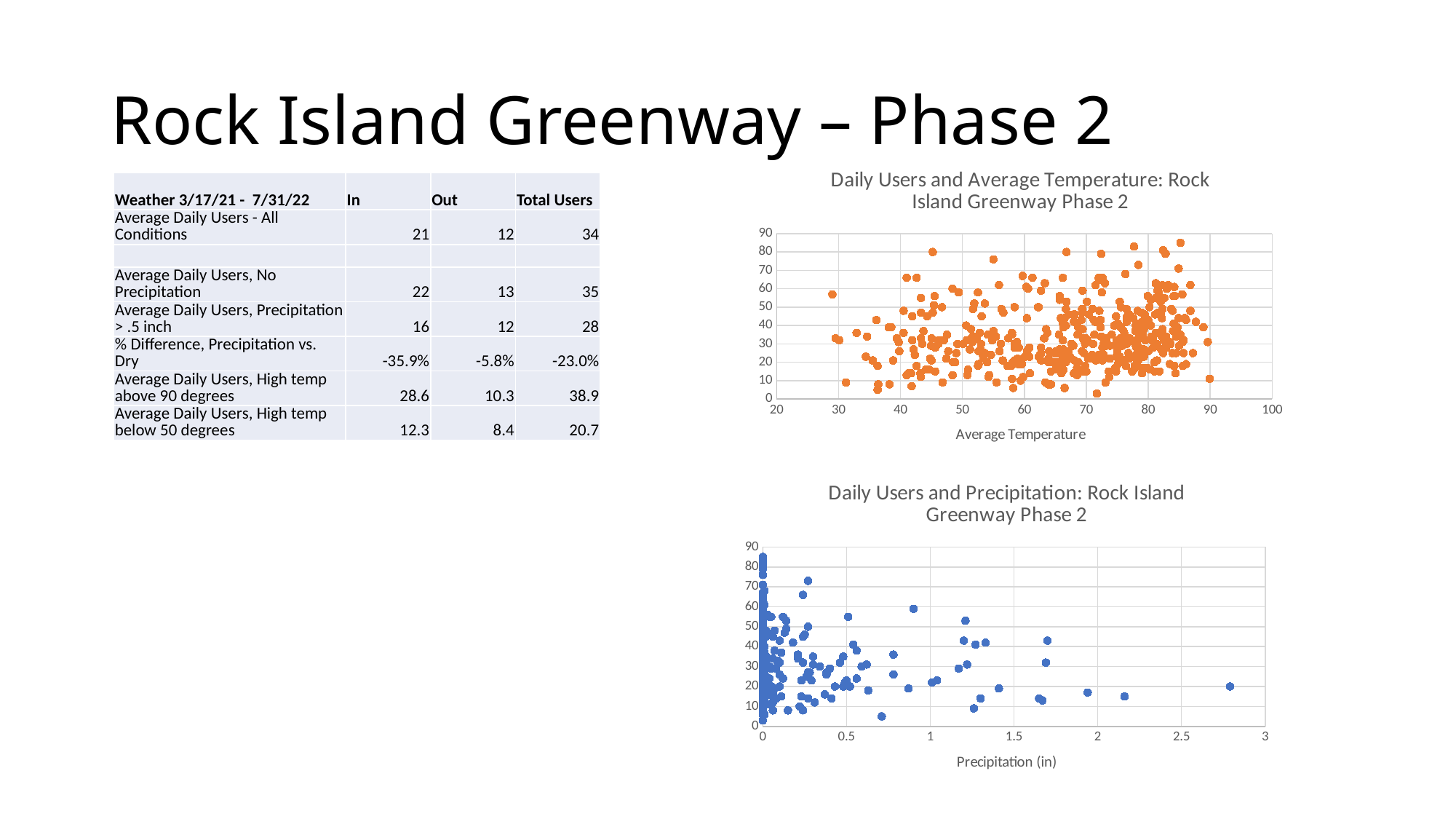
In the "Daily Users and Precipitation" chart, what is the label on the x axis? Precipitation (in) In the "Daily Users and Precipitation" chart, is the largest precipitation value plotted greater or less than 2.5? greater In the "Daily Users and Precipitation" chart, is the daily users value for the rightmost point (near 2.8 inches) greater or less than 30? less In the "Daily Users and Average Temperature" chart, what is the label on the x axis? Average Temperature In the "Daily Users and Average Temperature" chart, is the lowest average temperature plotted greater or less than 40? less What kind of chart is "Daily Users and Precipitation: Rock Island Greenway Phase 2"? Scatter chart How many charts are shown on the slide? 2 What kind of chart is "Daily Users and Average Temperature: Rock Island Greenway Phase 2"? Scatter chart In the "Daily Users and Precipitation" chart, do the daily users values generally rise or fall as precipitation increases? fall